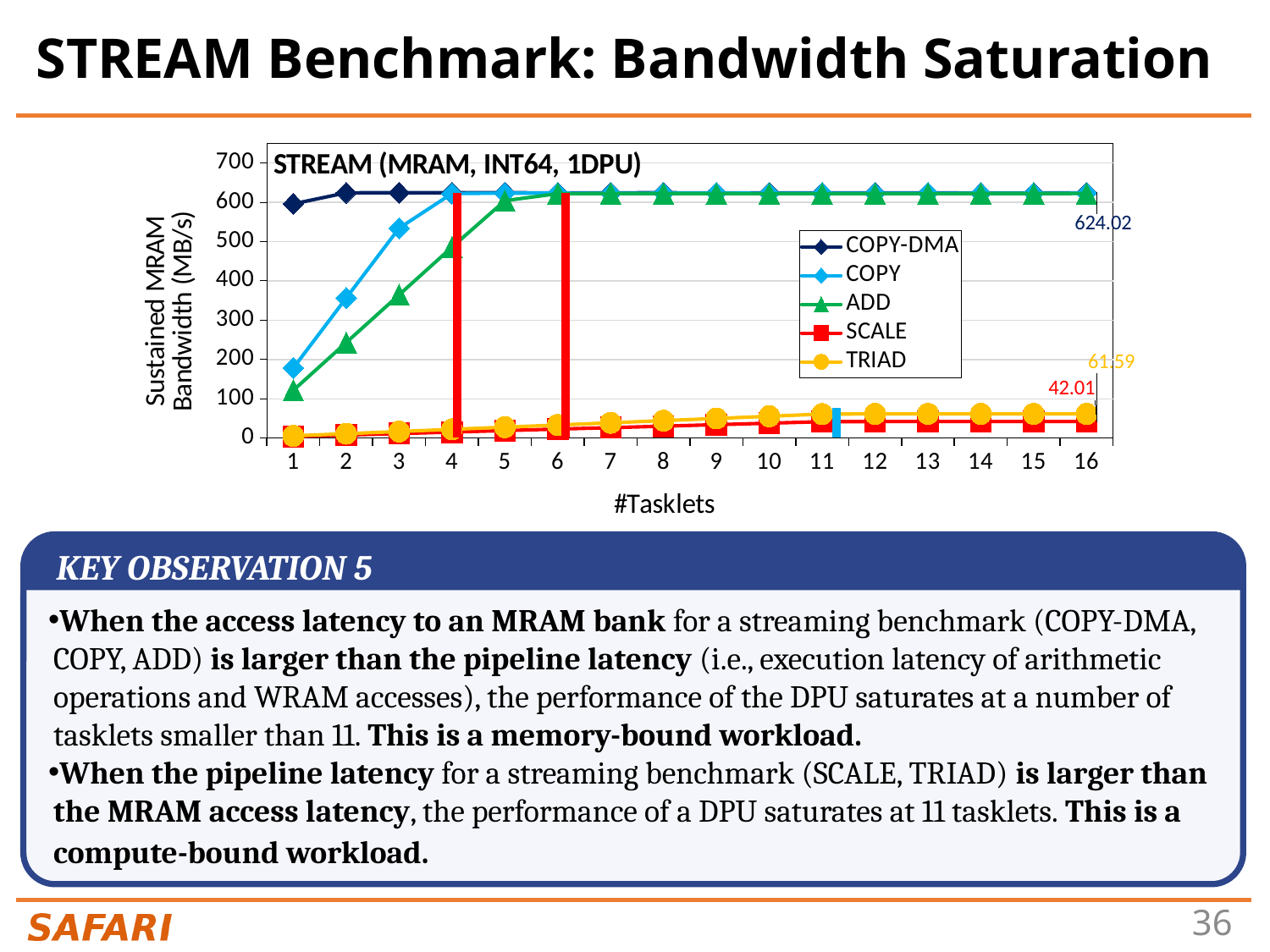
How many tasklet values are plotted along the x axis? 16 How many series does the chart legend list? 5 Is the value for ADD at 4 tasklets greater or less than 500? less What type of chart is shown on the slide? line chart What is the sustained MRAM bandwidth for SCALE at 16 tasklets? 42.01 What is the sustained MRAM bandwidth for TRIAD at 16 tasklets? 61.59 What is the difference between the TRIAD and SCALE bandwidth values at 16 tasklets? 19.58 Is the value for COPY at 1 tasklet greater or less than 100? greater What is the sustained MRAM bandwidth for COPY-DMA at 16 tasklets? 624.02 Which series has the lowest bandwidth at 16 tasklets? SCALE Which series has the highest bandwidth at 1 tasklet? COPY-DMA What is the title printed inside the chart area? STREAM (MRAM, INT64, 1DPU)